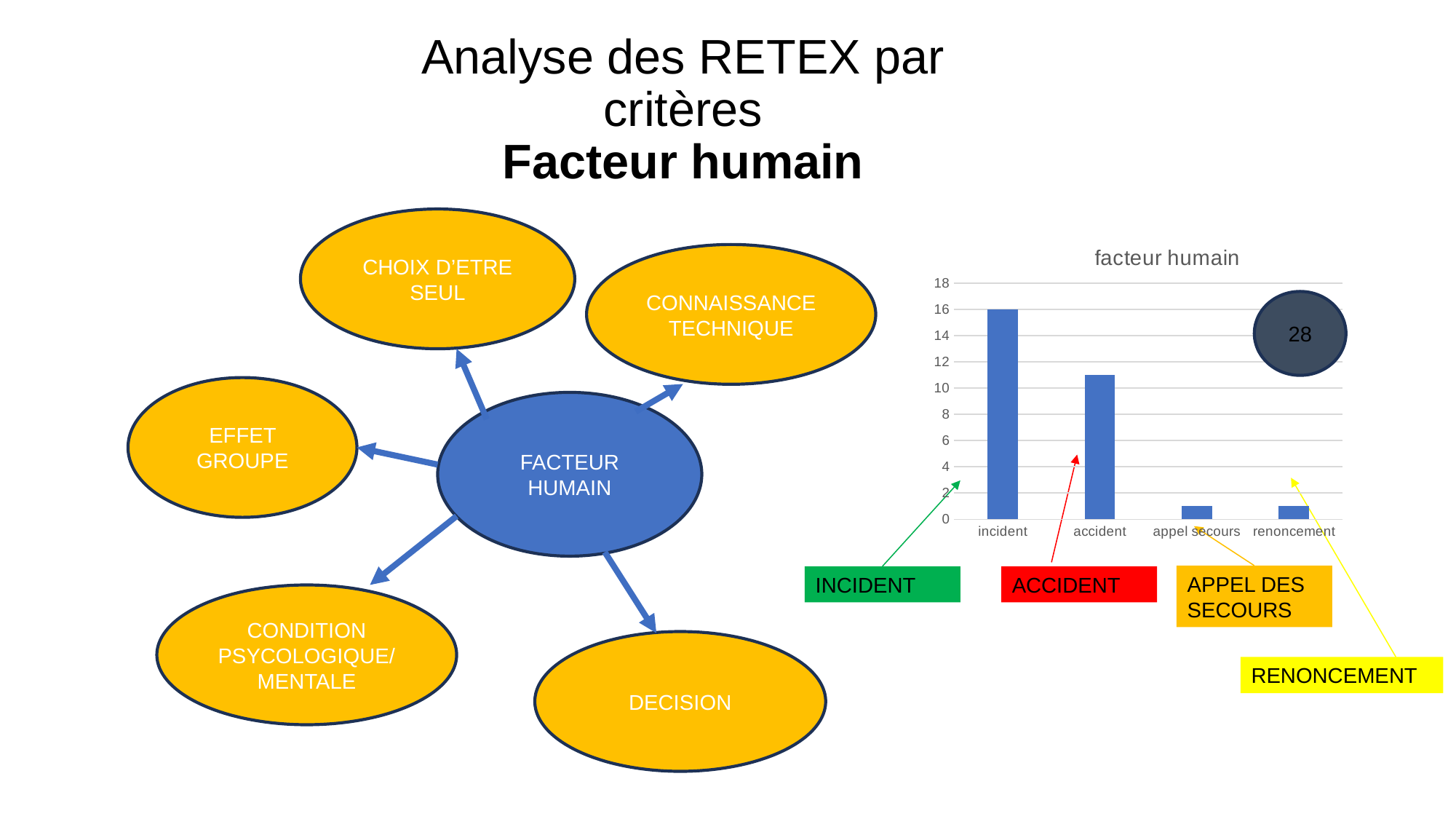
What number is written in the dark circle placed on the 'facteur humain' chart? 28 In the 'facteur humain' chart, which is larger, the value for 'incident' or the value for 'accident'? incident Do the values in the 'facteur humain' chart generally rise or fall from left to right along the x axis? fall Which category has the highest value in the 'facteur humain' chart? incident Is the value for 'appel secours' in the 'facteur humain' chart greater or less than 2? less How many categories are shown on the x axis of the 'facteur humain' chart? 4 Is the value for 'accident' in the 'facteur humain' chart greater or less than 10? greater Is the value for 'accident' in the 'facteur humain' chart greater or less than 12? less What kind of chart is the 'facteur humain' chart? bar chart What is the value for 'incident' in the 'facteur humain' chart? 16 What is the title of the chart on the right of the slide? facteur humain